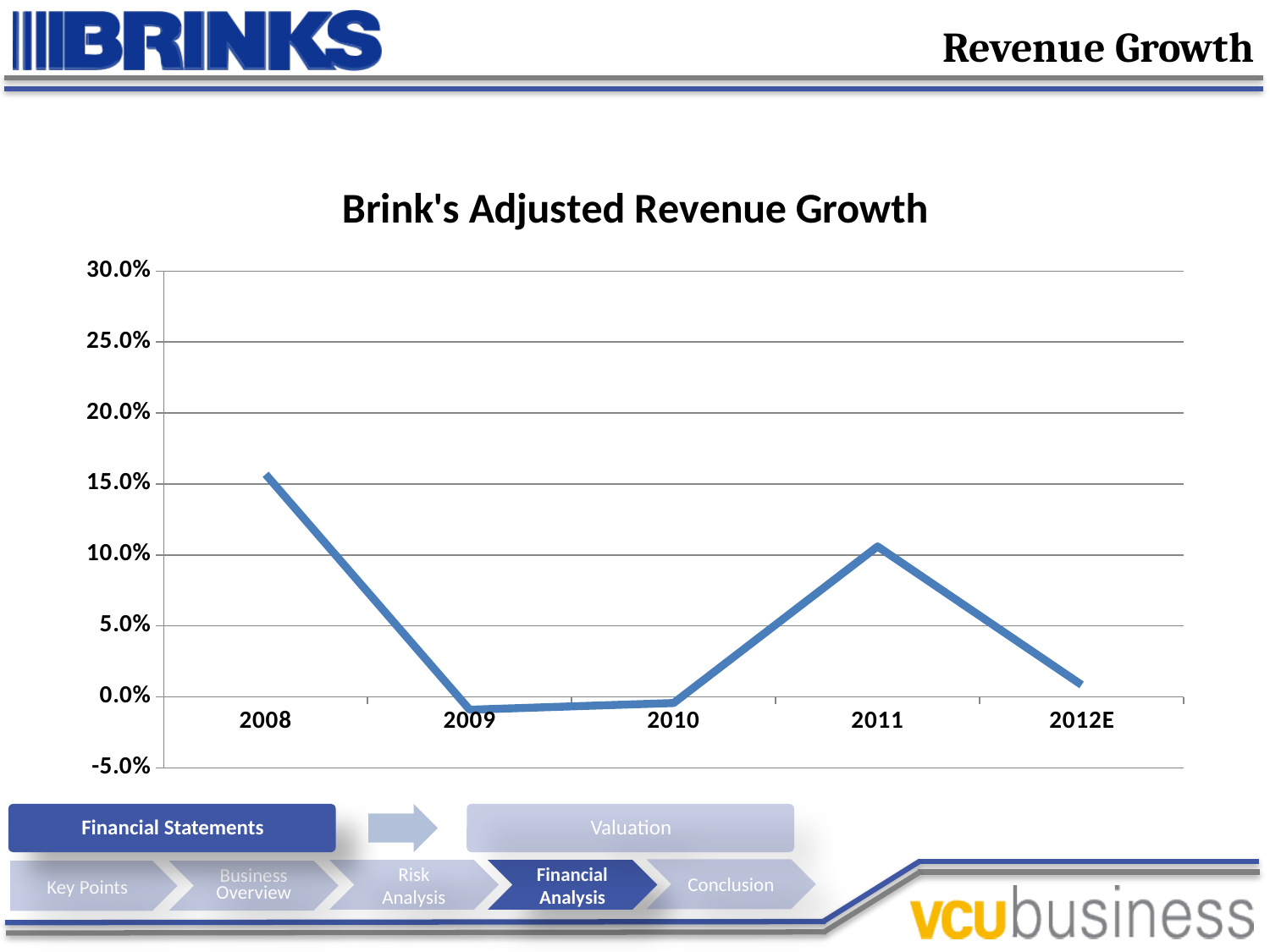
Is the adjusted revenue growth for 2010 greater or less than 5.0%? less How many years are plotted on the x axis of the chart? 5 What type of chart is shown on the slide? Line chart What is the title of the chart? Brink's Adjusted Revenue Growth Does the adjusted revenue growth rise or fall from 2010 to 2011? rise Is the adjusted revenue growth for 2008 greater or less than 10.0%? greater What is the highest value shown on the y axis of the chart? 30.0% Which is larger, the adjusted revenue growth in 2011 or in 2012E? 2011 Which year has the highest adjusted revenue growth? 2008 Is the adjusted revenue growth for 2012E greater or less than 5.0%? less Which is larger, the adjusted revenue growth in 2008 or in 2011? 2008